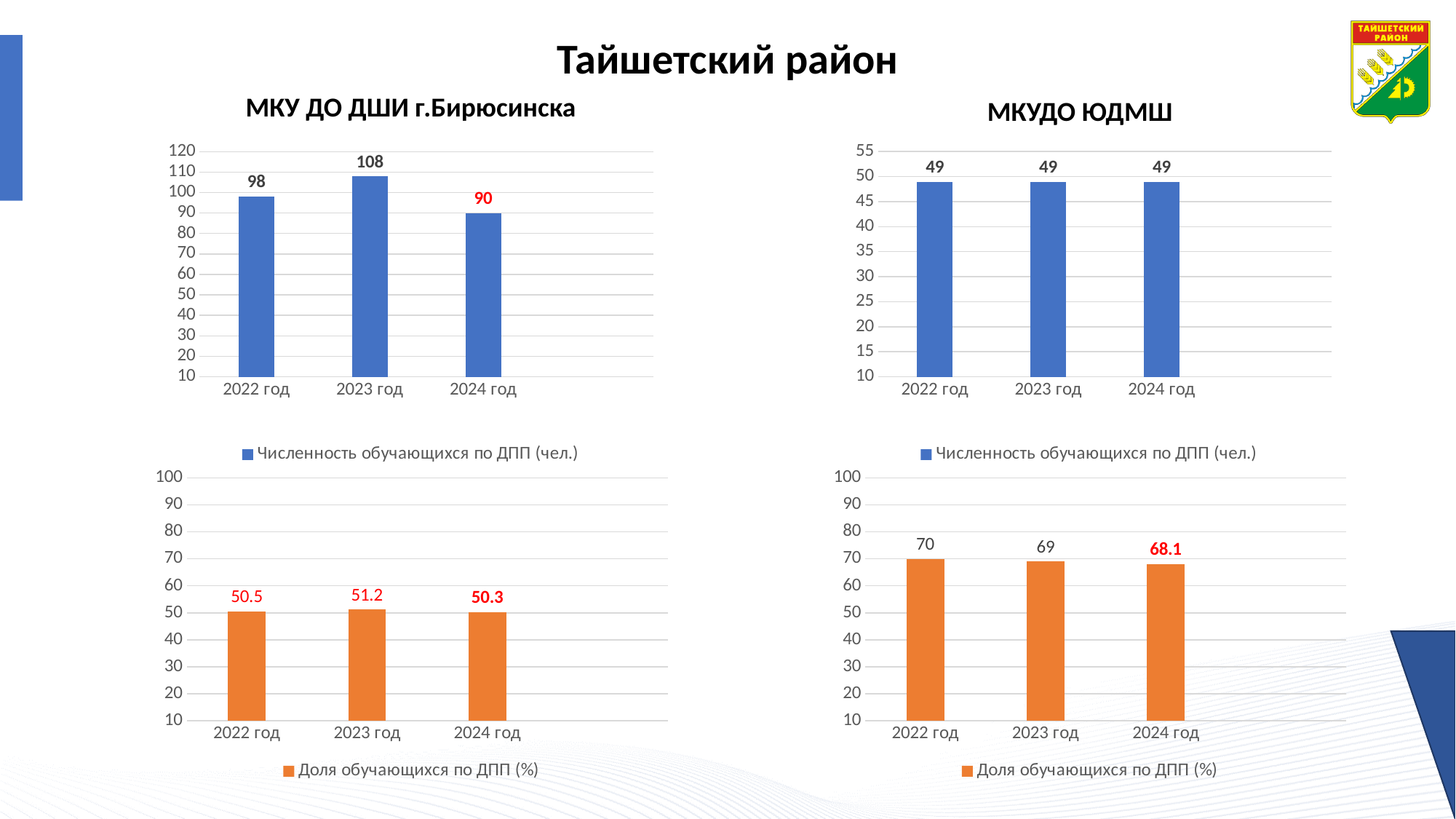
In the top-left chart (МКУ ДО ДШИ г.Бирюсинска, Численность обучающихся по ДПП), which year has the lowest value? 2024 год In the top-right chart (МКУДО ЮДМШ, Численность обучающихся по ДПП), what is the value for 2022 год? 49 In the bottom-left chart (МКУ ДО ДШИ г.Бирюсинска, Доля обучающихся по ДПП), which year has the highest value? 2023 год In the top-right chart (МКУДО ЮДМШ, Численность обучающихся по ДПП), do the values rise, fall or stay the same from 2022 год to 2024 год? stay the same In the top-left chart (МКУ ДО ДШИ г.Бирюсинска, Численность обучающихся по ДПП), what is the difference between 2023 год and 2022 год? 10 In the bottom-right chart (МКУДО ЮДМШ, Доля обучающихся по ДПП), do the values rise or fall from 2022 год to 2024 год? fall In the bottom-left chart (МКУ ДО ДШИ г.Бирюсинска, Доля обучающихся по ДПП), what is the value for 2024 год? 50.3 How many years are shown on the x axis of the top-left chart (МКУ ДО ДШИ г.Бирюсинска, Численность обучающихся по ДПП)? 3 In the bottom-right chart (МКУДО ЮДМШ, Доля обучающихся по ДПП), which is larger, the value for 2022 год or 2024 год? 2022 год What kind of chart is the bottom-left chart (МКУ ДО ДШИ г.Бирюсинска, Доля обучающихся по ДПП)? bar chart In the bottom-right chart (МКУДО ЮДМШ, Доля обучающихся по ДПП), what is the value for 2024 год? 68.1 In the top-left chart (МКУ ДО ДШИ г.Бирюсинска, Численность обучающихся по ДПП), what is the value for 2023 год? 108